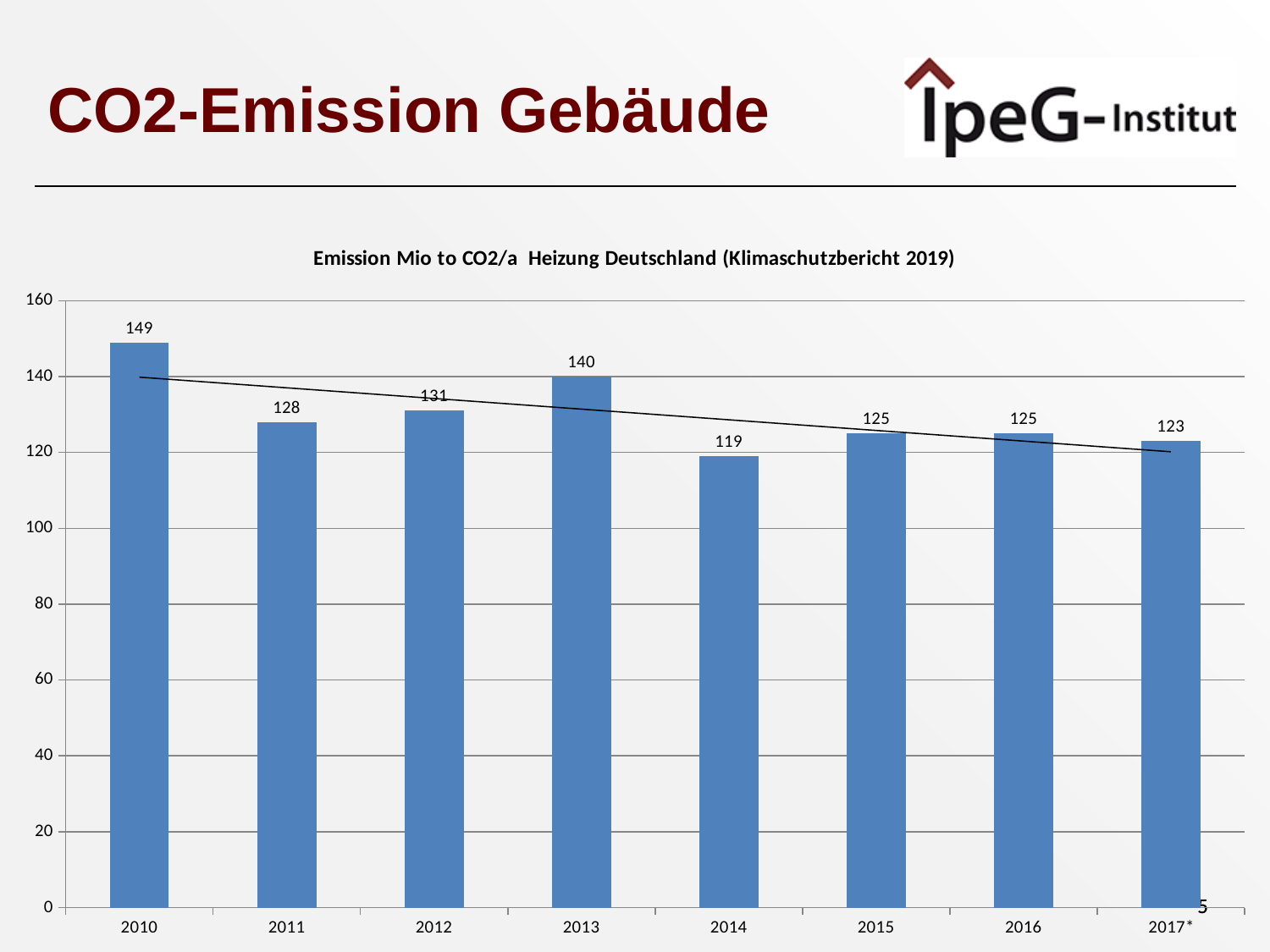
What is the value for 2010? 149 Which is larger, the value for 2012 or the value for 2013? 2013 What is the difference between the values for 2013 and 2014? 21 What is the title of the chart? Emission Mio to CO2/a Heizung Deutschland (Klimaschutzbericht 2019) What is the value for 2014? 119 Is the value for 2011 greater or less than 120? greater What is the value for 2017*? 123 Which year has the lowest value? 2014 How many years are shown on the x axis? 8 Which year has the highest value? 2010 What kind of chart is this? bar chart What is the difference between the values for 2010 and 2017*? 26